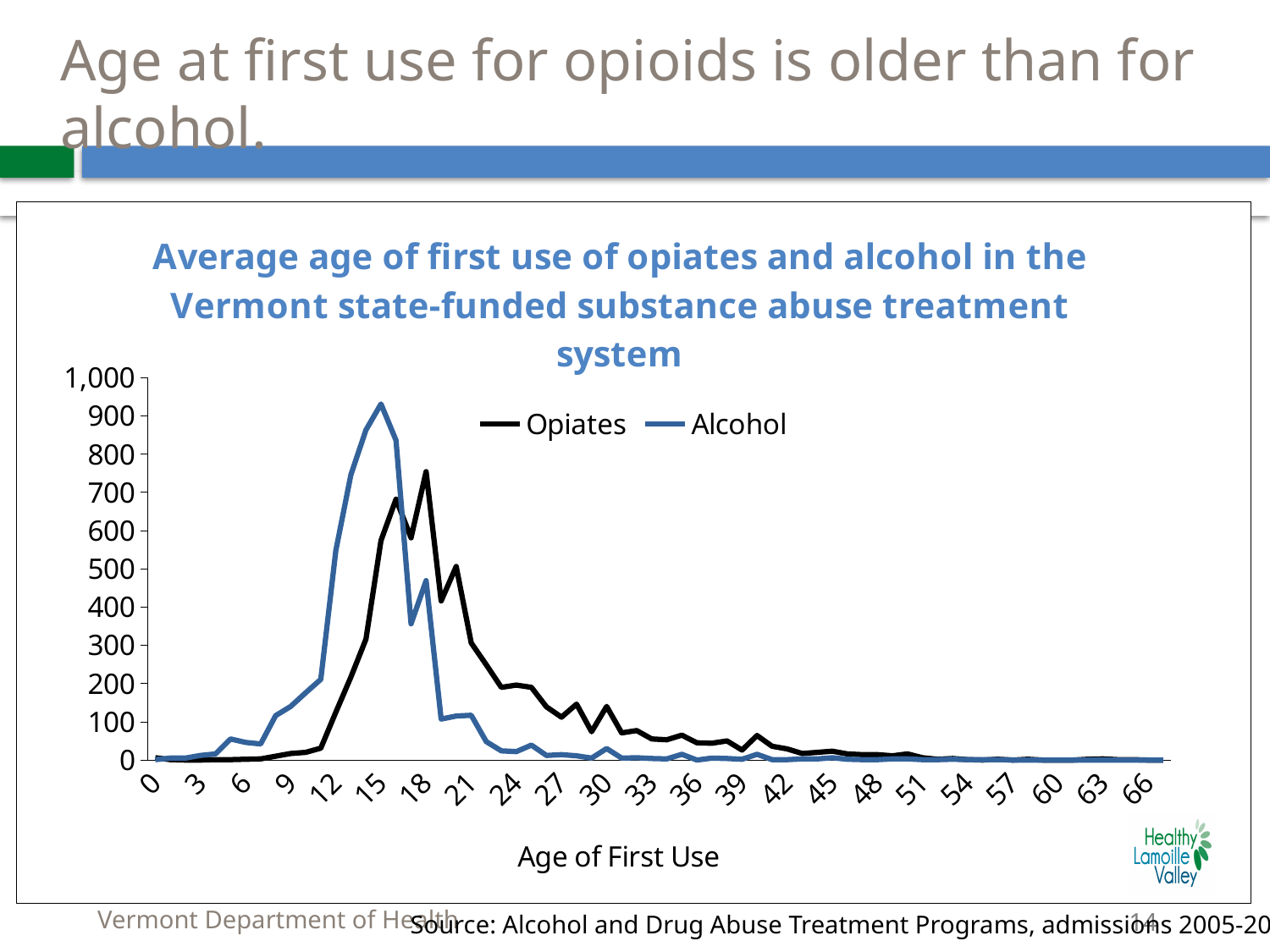
Is the peak value of the Alcohol series greater or less than 800? greater How many series does the legend list? 2 What is the title of the x axis? Age of First Use Is the peak value of the Opiates series greater or less than 700? greater Is the value for Alcohol at age 21 greater or less than 200? less Which series reaches the higher peak value, Opiates or Alcohol? Alcohol Does the Alcohol series rise or fall between age 15 and age 24? fall At age 21, which series has the larger value, Opiates or Alcohol? Opiates What kind of chart is shown on the slide? Line chart Does the Opiates series rise or fall between age 9 and age 18? rise At age 15, which series has the larger value, Opiates or Alcohol? Alcohol What are the two series named in the legend? Opiates and Alcohol